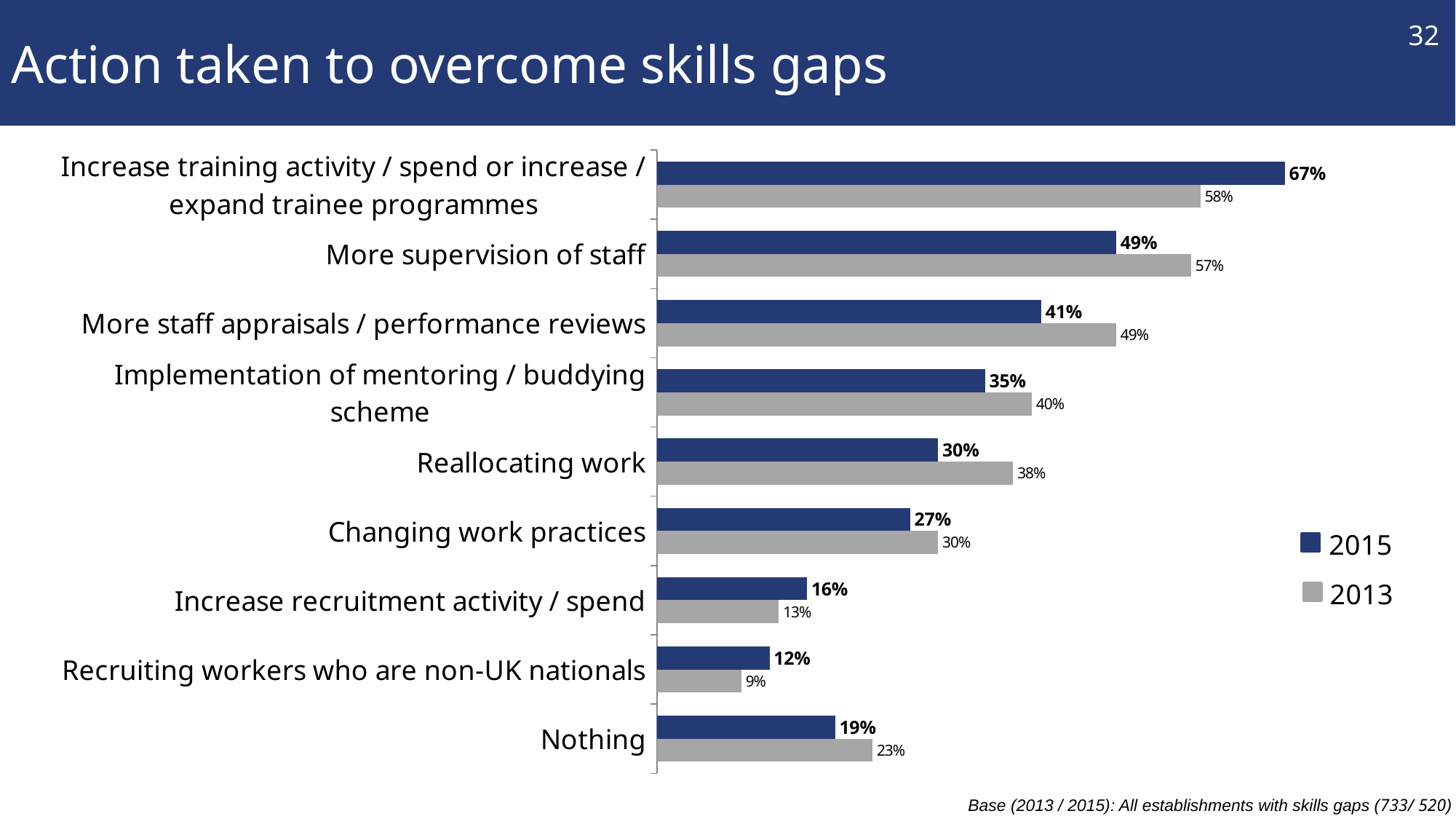
What is the 2015 value for 'More supervision of staff'? 49% What is the 2015 value for 'Nothing'? 19% What is the difference between the 2015 and 2013 values for 'More staff appraisals / performance reviews'? 8% Which category has the lowest 2013 value? Recruiting workers who are non-UK nationals Which category has the highest 2015 value? Increase training activity / spend or increase / expand trainee programmes What is the difference between the 2013 and 2015 values for 'Changing work practices'? 3% Which is larger for 'Increase recruitment activity / spend': the 2015 value or the 2013 value? 2015 How many categories are shown on the chart? 9 What is the 2013 value for 'Reallocating work'? 38% Which series is shown in grey in the legend? 2013 How many series does the legend list? 2 What kind of chart is shown on the slide? Bar chart